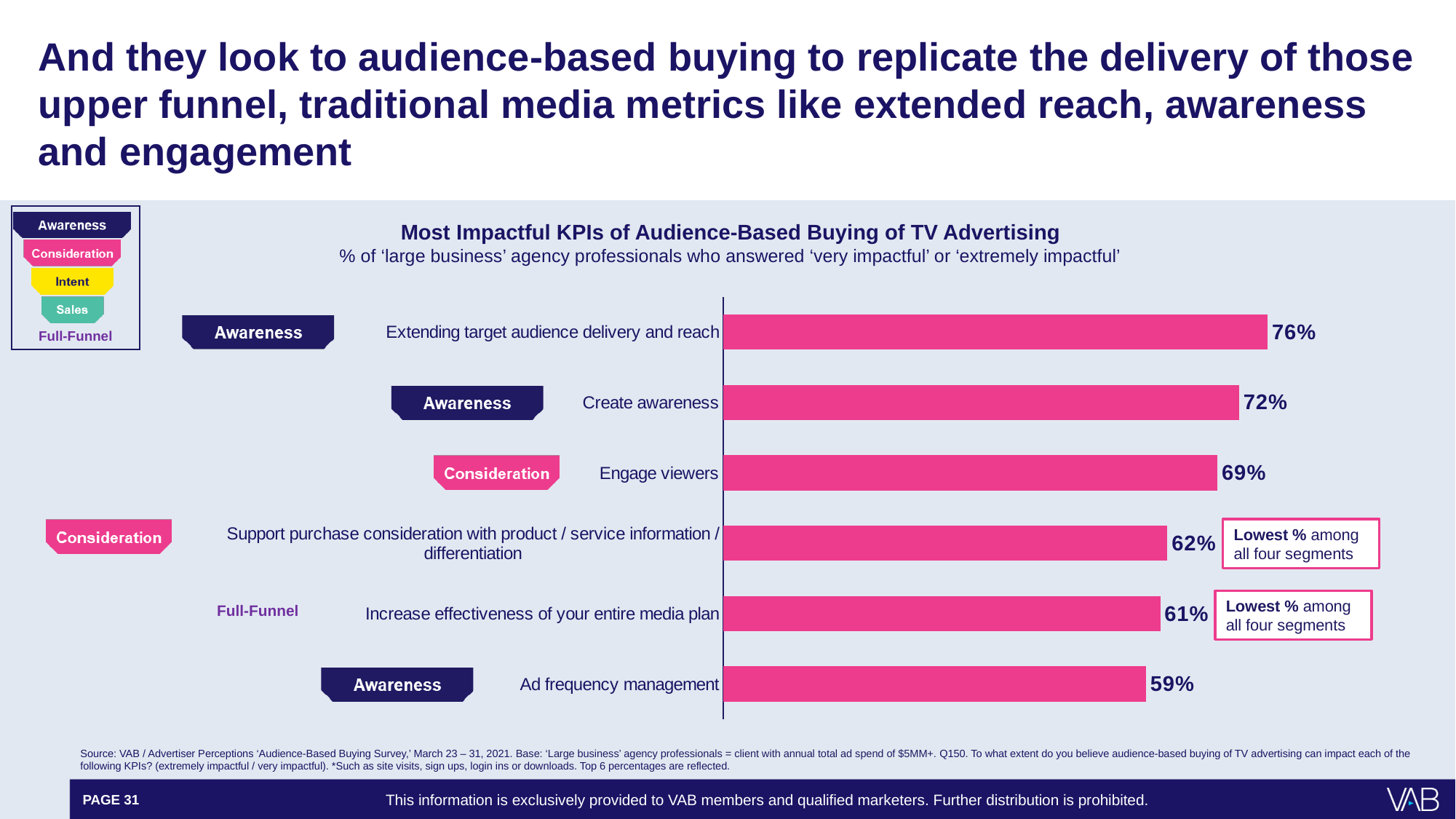
Which KPI has the highest percentage in the chart? Extending target audience delivery and reach What is the difference in percentage points between 'Extending target audience delivery and reach' and 'Ad frequency management'? 17 Which has a higher value: 'Support purchase consideration with product / service information / differentiation' or 'Increase effectiveness of your entire media plan'? Support purchase consideration with product / service information / differentiation What is the difference in percentage points between 'Create awareness' and 'Engage viewers'? 3 What is the value shown for 'Engage viewers'? 69% What type of chart is used to show the most impactful KPIs? Bar chart What is the value shown for 'Ad frequency management'? 59% What is the title of the chart? Most Impactful KPIs of Audience-Based Buying of TV Advertising Which KPI has the lowest percentage in the chart? Ad frequency management What percentage of 'large business' agency professionals rated 'Extending target audience delivery and reach' as very or extremely impactful? 76% What is the value shown for 'Create awareness'? 72% How many KPIs are plotted in the chart? 6